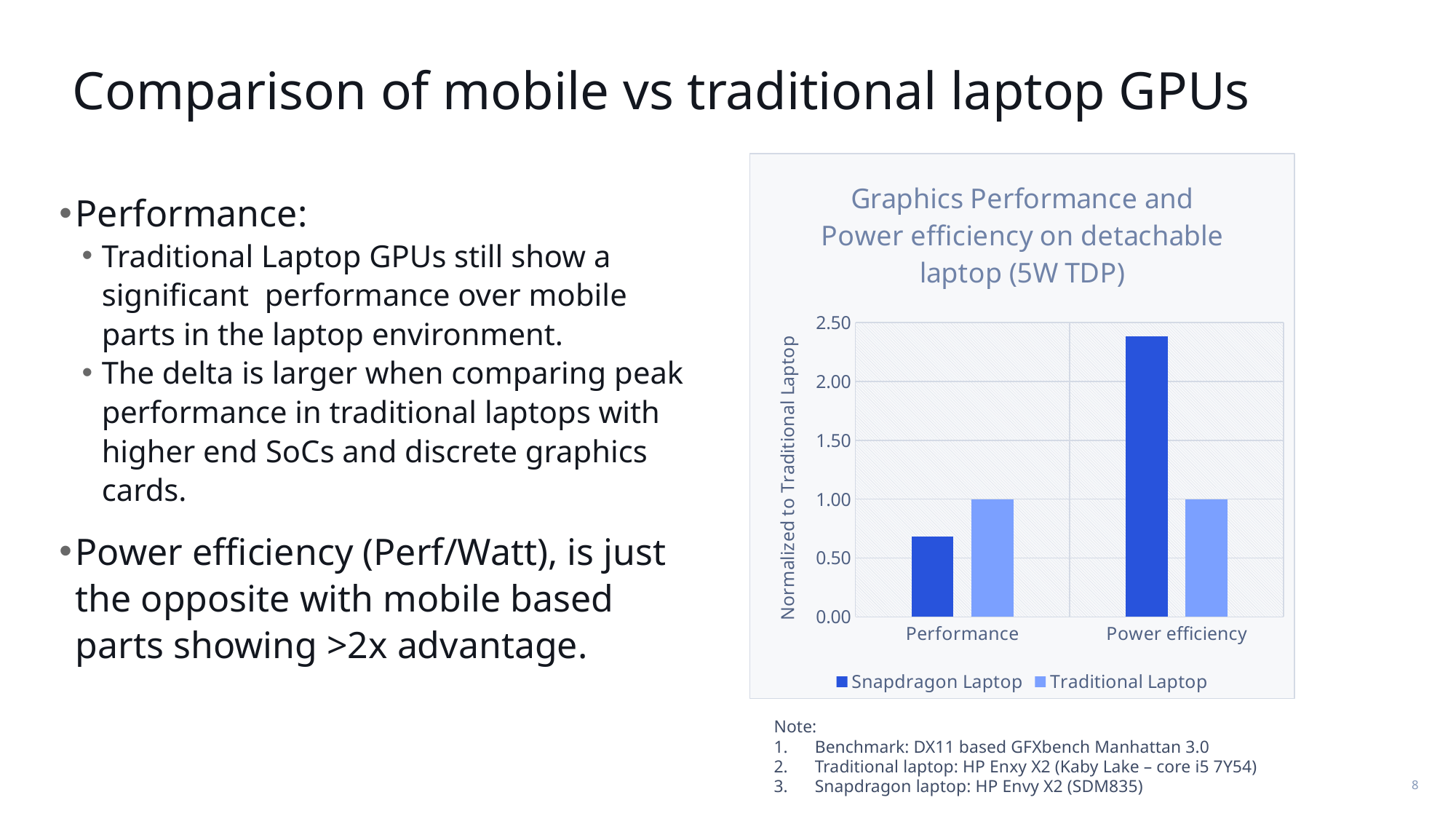
How many series does the chart legend list? 2 Which series has the higher value in the Performance category? Traditional Laptop Which series has the higher value in the Power efficiency category? Snapdragon Laptop How many categories are shown on the x axis of the chart? 2 Is the value for Snapdragon Laptop in the Performance category greater or less than 1.00? less What kind of chart is shown on the slide? bar chart What is the title of the chart? Graphics Performance and Power efficiency on detachable laptop (5W TDP) What is the value for Traditional Laptop in the Power efficiency category? 1.00 What is the label of the y axis of the chart? Normalized to Traditional Laptop Is the value for Snapdragon Laptop in the Power efficiency category greater or less than 2.00? greater Which category has the highest Snapdragon Laptop bar? Power efficiency What is the value for Traditional Laptop in the Performance category? 1.00